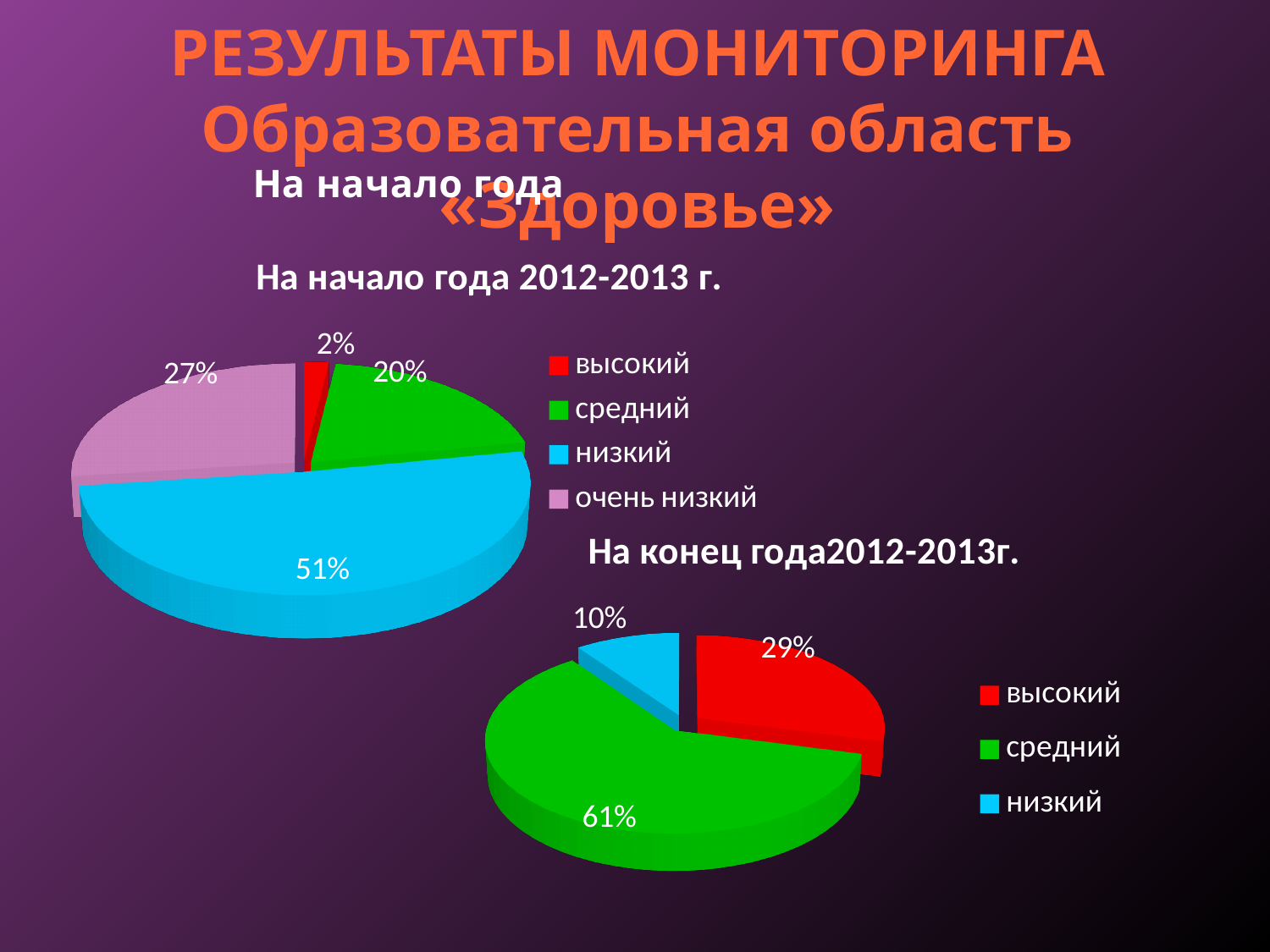
In the chart 'На начало года 2012-2013 г.', which category has the smallest share? высокий What kind of chart is 'На конец года2012-2013г.'? pie chart In the chart 'На начало года 2012-2013 г.', what share does 'очень низкий' have? 27% In the chart 'На начало года 2012-2013 г.', what share does 'высокий' have? 2% In the chart 'На конец года2012-2013г.', which category has the smallest share? низкий In the chart 'На конец года2012-2013г.', what share does 'высокий' have? 29% In the chart 'На конец года2012-2013г.', what is the difference between the shares of 'средний' and 'высокий'? 32% In the chart 'На конец года2012-2013г.', which colour represents 'низкий'? blue In the chart 'На начало года 2012-2013 г.', how many categories does the legend list? 4 In the chart 'На конец года2012-2013г.', what share does 'средний' have? 61% In the chart 'На начало года 2012-2013 г.', what share does 'низкий' have? 51% In the chart 'На начало года 2012-2013 г.', which category has the largest share? низкий